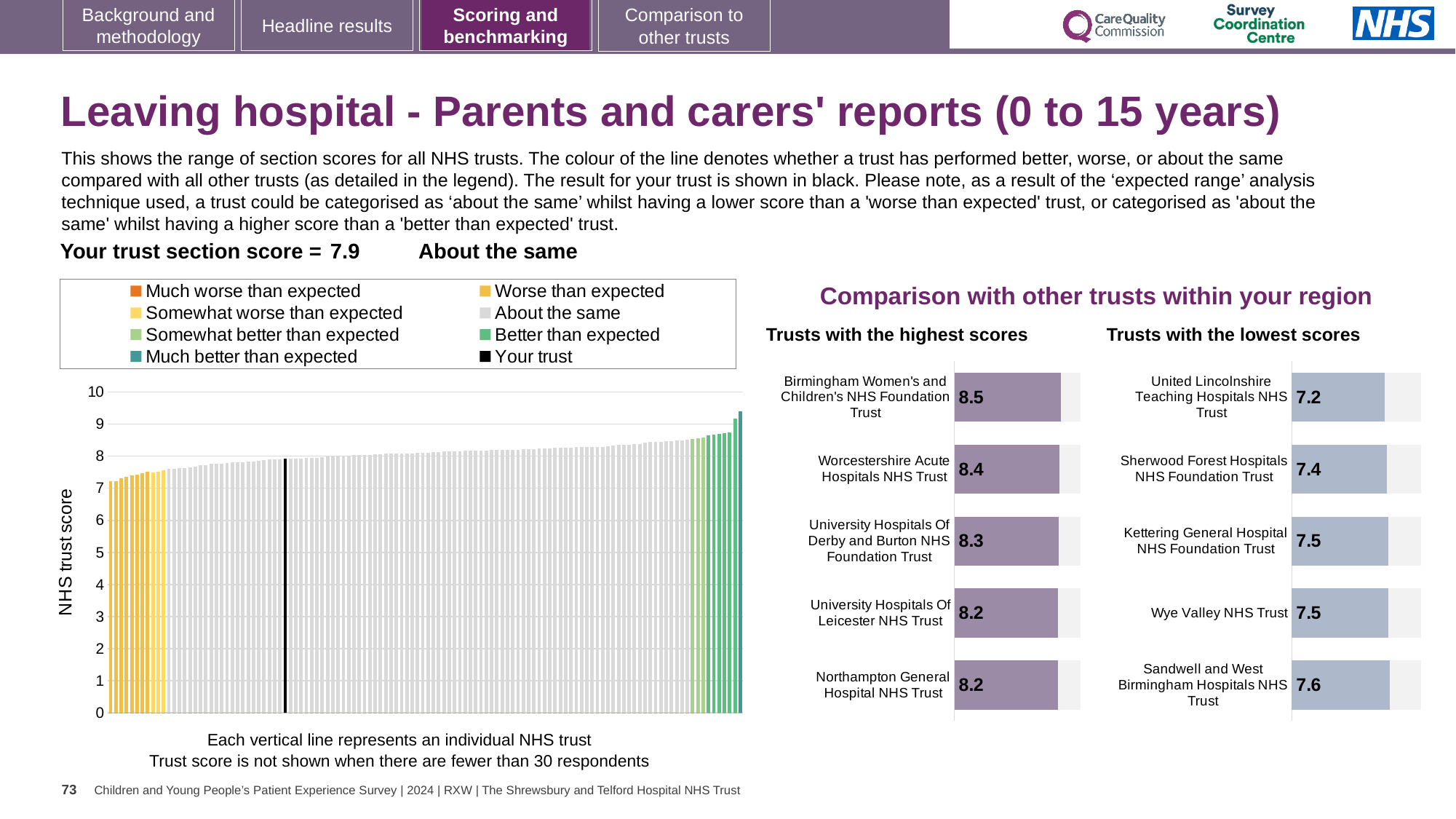
In the chart on the left showing all NHS trusts, what kind of chart is it? bar chart In the 'Trusts with the lowest scores' chart, which trust has the lowest score? United Lincolnshire Teaching Hospitals NHS Trust In the 'Trusts with the lowest scores' chart, which has the larger score, Sherwood Forest Hospitals NHS Foundation Trust or Sandwell and West Birmingham Hospitals NHS Trust? Sandwell and West Birmingham Hospitals NHS Trust In the 'Trusts with the lowest scores' chart, what is the score for Kettering General Hospital NHS Foundation Trust? 7.5 In the chart on the left showing all NHS trusts, how many entries does the legend list? 8 In the 'Trusts with the highest scores' chart, what is the score for Worcestershire Acute Hospitals NHS Trust? 8.4 In the chart on the left showing all NHS trusts, what is the section score for your trust? 7.9 In the chart on the left showing all NHS trusts, do the bar values rise or fall from left to right? rise In the 'Trusts with the highest scores' chart, which trust has the highest score? Birmingham Women's and Children's NHS Foundation Trust In the 'Trusts with the highest scores' chart, what is the difference between the scores of Birmingham Women's and Children's NHS Foundation Trust and Northampton General Hospital NHS Trust? 0.3 In the 'Trusts with the highest scores' chart, how many trusts are shown? 5 In the chart on the left showing all NHS trusts, what is the label on the vertical axis? NHS trust score